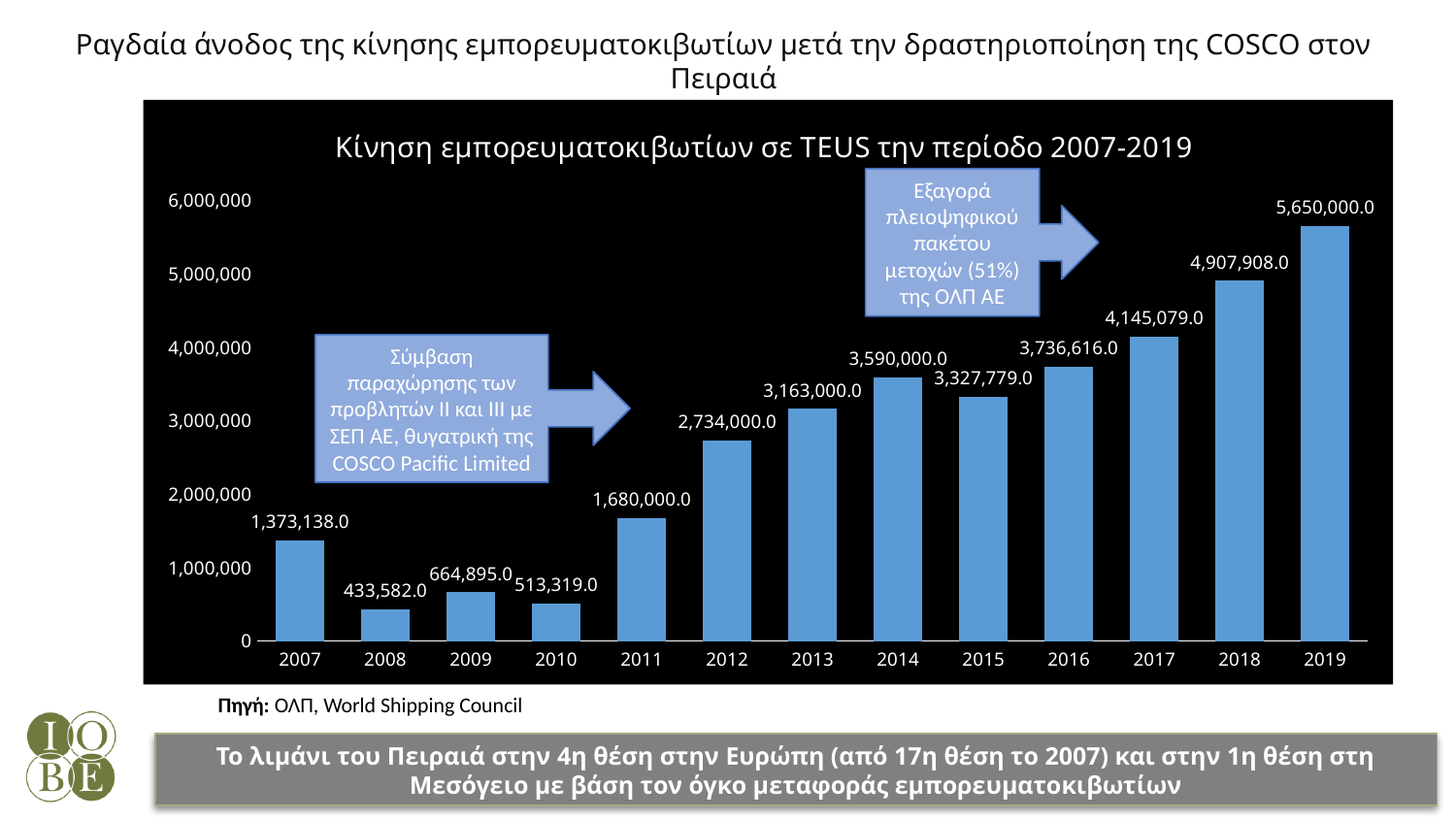
Do the values generally rise or fall from 2010 to 2019? Rise What is the container traffic value (TEUs) for 2012? 2,734,000.0 What is the title of the chart? Κίνηση εμπορευματοκιβωτίων σε TEUS την περίοδο 2007-2019 What is the difference between the 2019 and 2018 values? 742,092.0 What is the value shown for 2007? 1,373,138.0 Which year has the highest container traffic? 2019 How many years (bars) are shown in the chart? 13 What type of chart is shown on the slide? Bar chart Which year has the lowest container traffic? 2008 Which year has the larger value, 2014 or 2015? 2014 What is the difference between the 2014 and 2015 values? 262,221.0 What is the value shown for 2017? 4,145,079.0